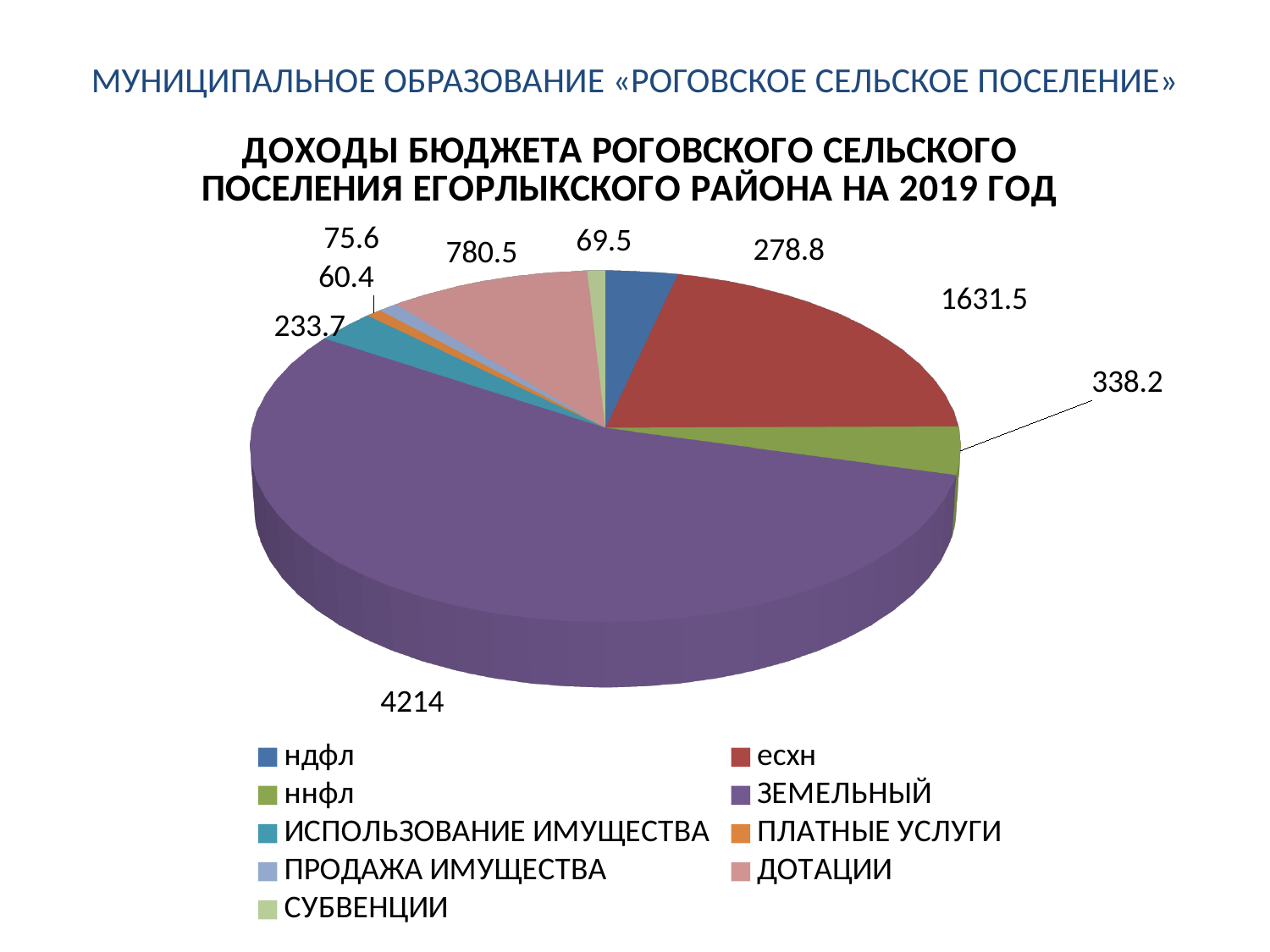
What is the value for ИСПОЛЬЗОВАНИЕ ИМУЩЕСТВА? 233.7 What type of chart is shown on the slide? pie chart How many categories does the legend list? 9 What is the value for ЗЕМЕЛЬНЫЙ? 4214 Which is larger, the value for ннфл or the value for ндфл? ннфл Which category has the largest slice? ЗЕМЕЛЬНЫЙ What is the value for ннфл? 338.2 What is the value for ДОТАЦИИ? 780.5 What is the difference between the values for есхн and ДОТАЦИИ? 851 What is the value for ндфл? 278.8 What is the difference between the values for ЗЕМЕЛЬНЫЙ and есхн? 2582.5 What is the value for есхн? 1631.5